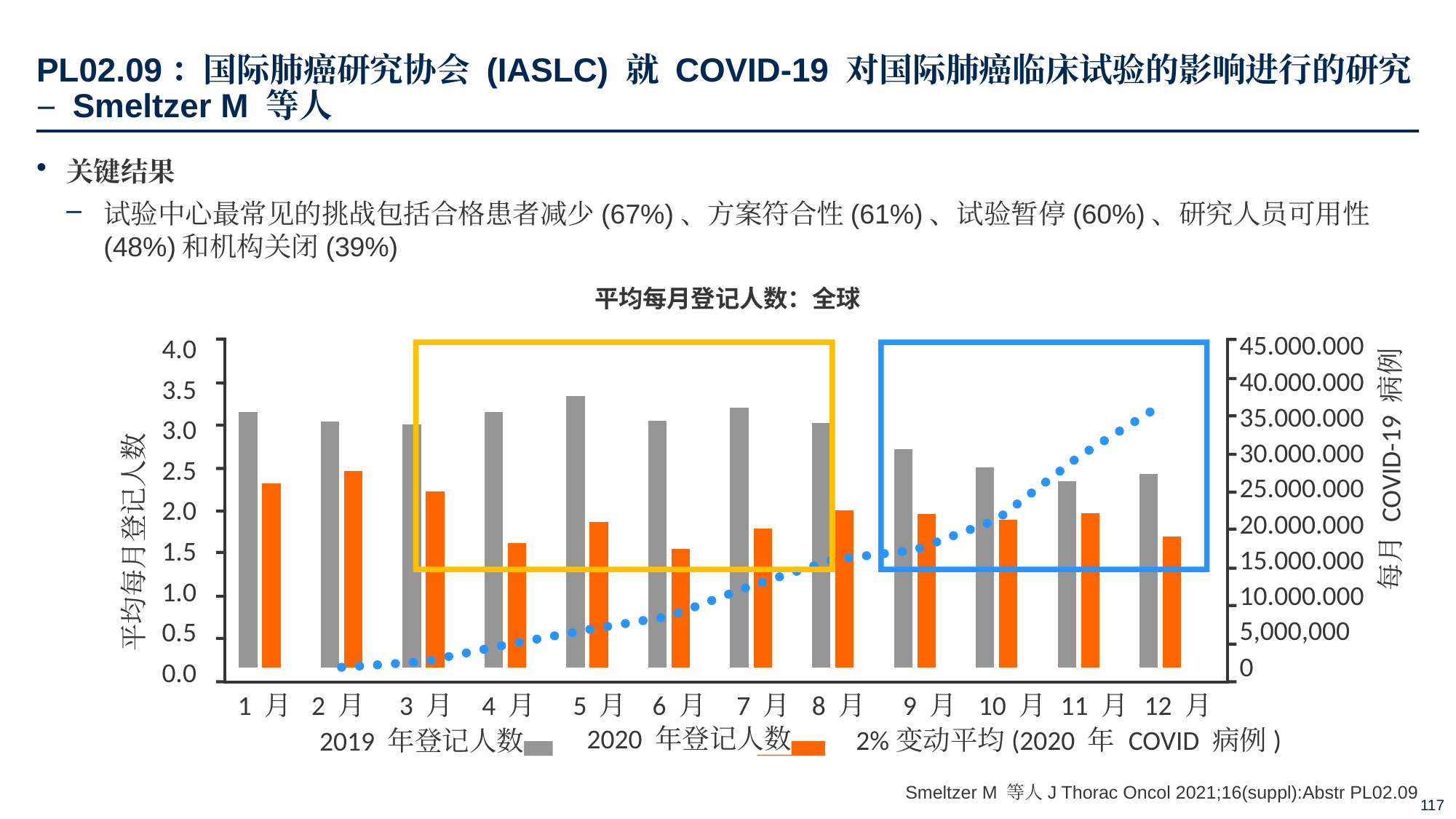
In 1 月, which is larger: 2019 年登记人数 or 2020 年登记人数? 2019 年登记人数 In which month is the 2019 年登记人数 bar highest? 5 月 What kind of chart is shown on the slide? bar chart Is the 2020 年登记人数 value for 1 月 greater or less than 2.0? greater Is the 2020 年登记人数 value for 6 月 greater or less than 2.0? less How many months are shown on the x axis of the chart? 12 Is the 2019 年登记人数 value for 5 月 greater or less than 3.0? greater Which colour represents 2020 年登记人数 in the chart? orange How many series does the chart legend list? 3 Does the dotted line for 2% 变动平均 (2020 年 COVID 病例) rise or fall from 1 月 to 12 月? rise What is the title of the chart? 平均每月登记人数：全球